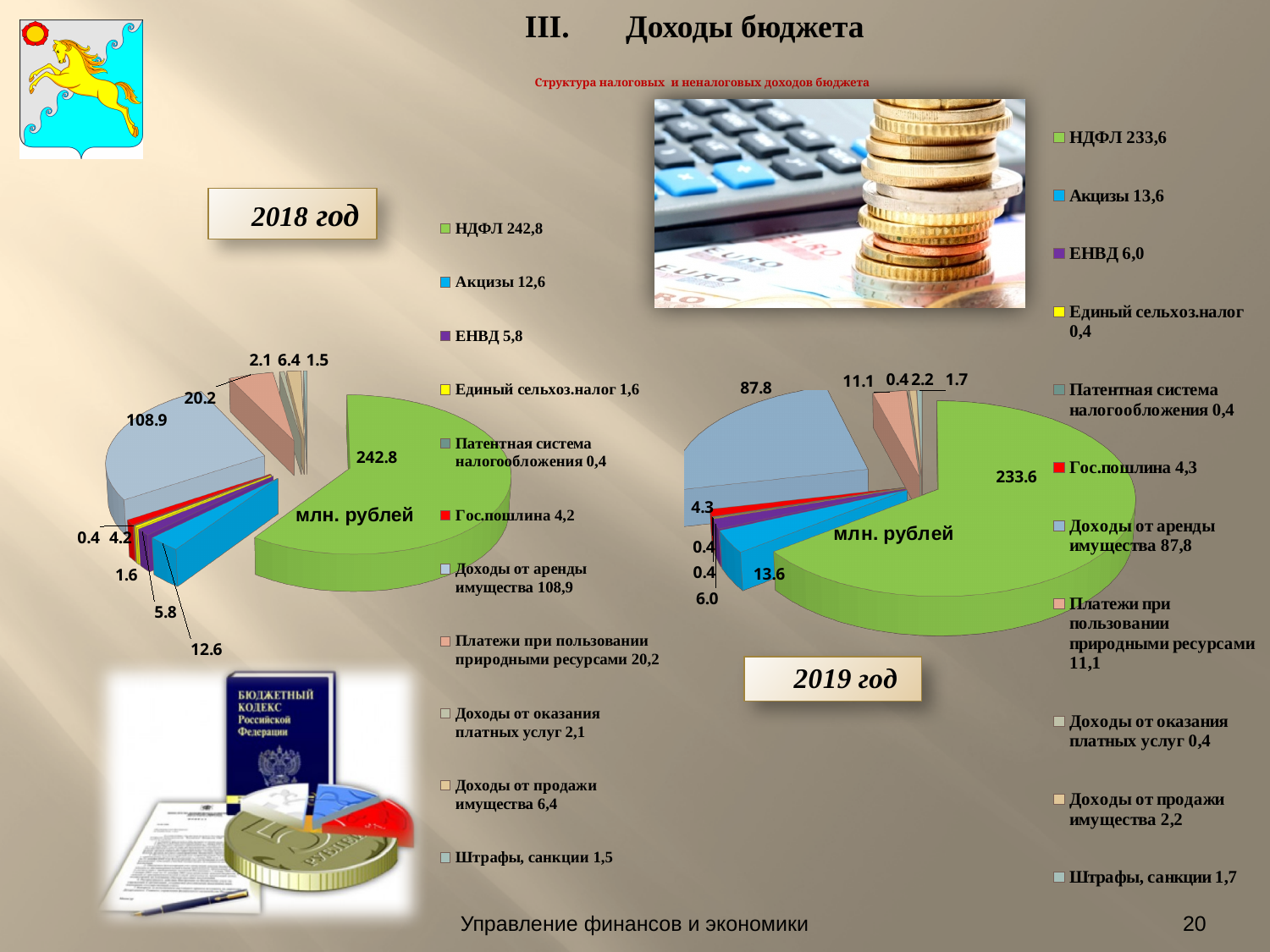
Which is larger: Акцизы in the 2018 год chart or Акцизы in the 2019 год chart? 2019 год In the 2019 год pie chart, which category has the largest value? НДФЛ In the 2018 год pie chart, what is the value for НДФЛ? 242.8 In the 2018 год pie chart, which category has the smallest value? Патентная система налогообложения In the 2019 год pie chart, what is the value for Акцизы? 13.6 In the 2018 год pie chart, what is the value for Платежи при пользовании природными ресурсами? 20.2 How many categories does the 2019 год pie chart have? 11 In the 2019 год pie chart, what is the value for Доходы от аренды имущества? 87.8 In the 2018 год pie chart, what is the difference between НДФЛ and Доходы от аренды имущества? 133.9 What type of chart is used for the 2018 год data? Pie chart What is the difference between the НДФЛ value in the 2018 год chart and the НДФЛ value in the 2019 год chart? 9.2 In the 2018 год pie chart, which category has the largest value? НДФЛ